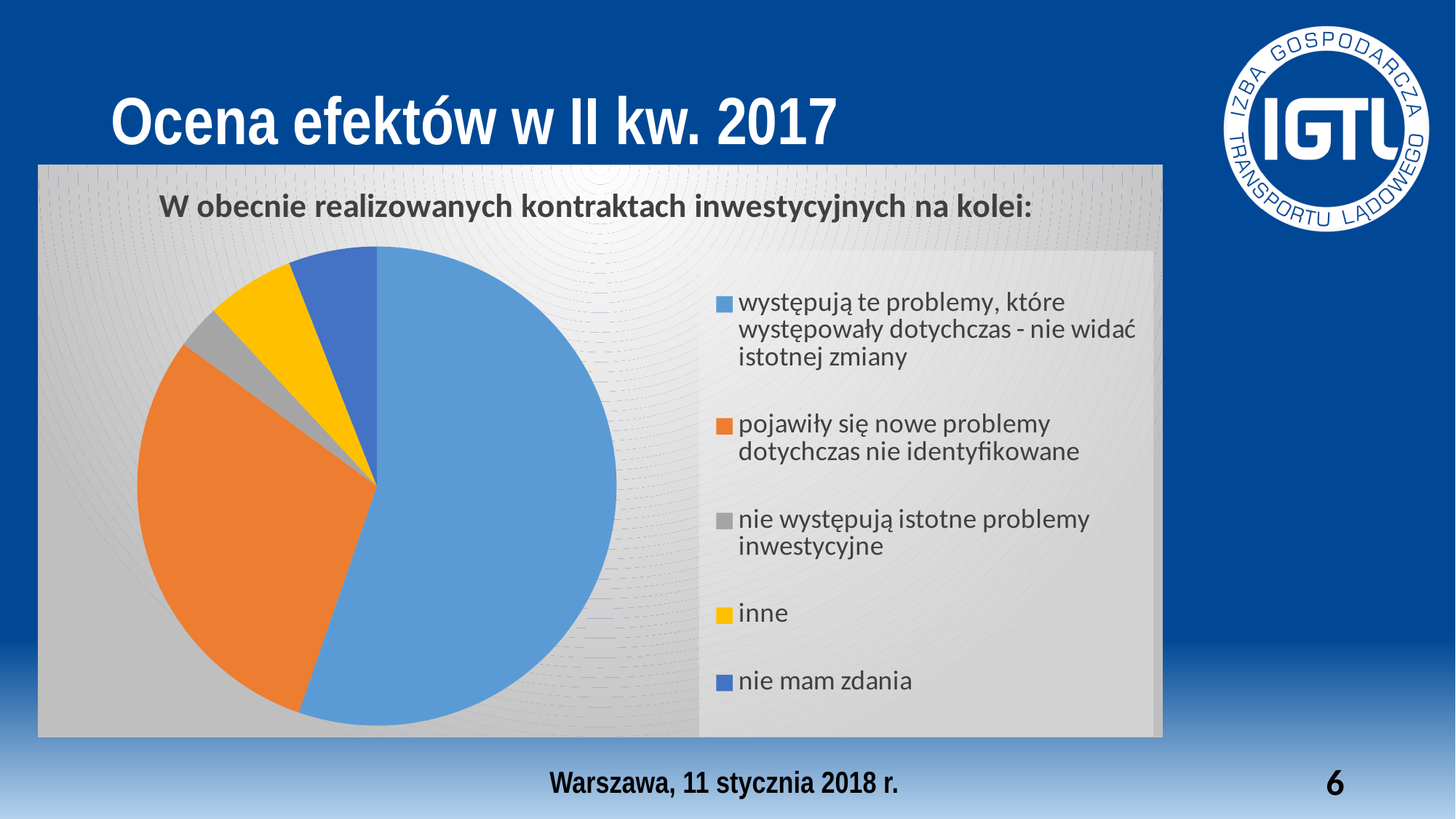
Which category has the largest slice of the pie? występują te problemy, które występowały dotychczas - nie widać istotnej zmiany Which slice is larger: "pojawiły się nowe problemy dotychczas nie identyfikowane" or "inne"? pojawiły się nowe problemy dotychczas nie identyfikowane How many entries does the chart legend list? 5 What kind of chart is shown on the slide? pie chart What is the title of the pie chart? W obecnie realizowanych kontraktach inwestycyjnych na kolei: How many slices does the pie chart have? 5 Which slice is larger: "występują te problemy, które występowały dotychczas - nie widać istotnej zmiany" or "pojawiły się nowe problemy dotychczas nie identyfikowane"? występują te problemy, które występowały dotychczas - nie widać istotnej zmiany Which slice is larger: "nie mam zdania" or "nie występują istotne problemy inwestycyjne"? nie mam zdania Which category has the smallest slice of the pie? nie występują istotne problemy inwestycyjne What colour is the slice for "inne"? yellow